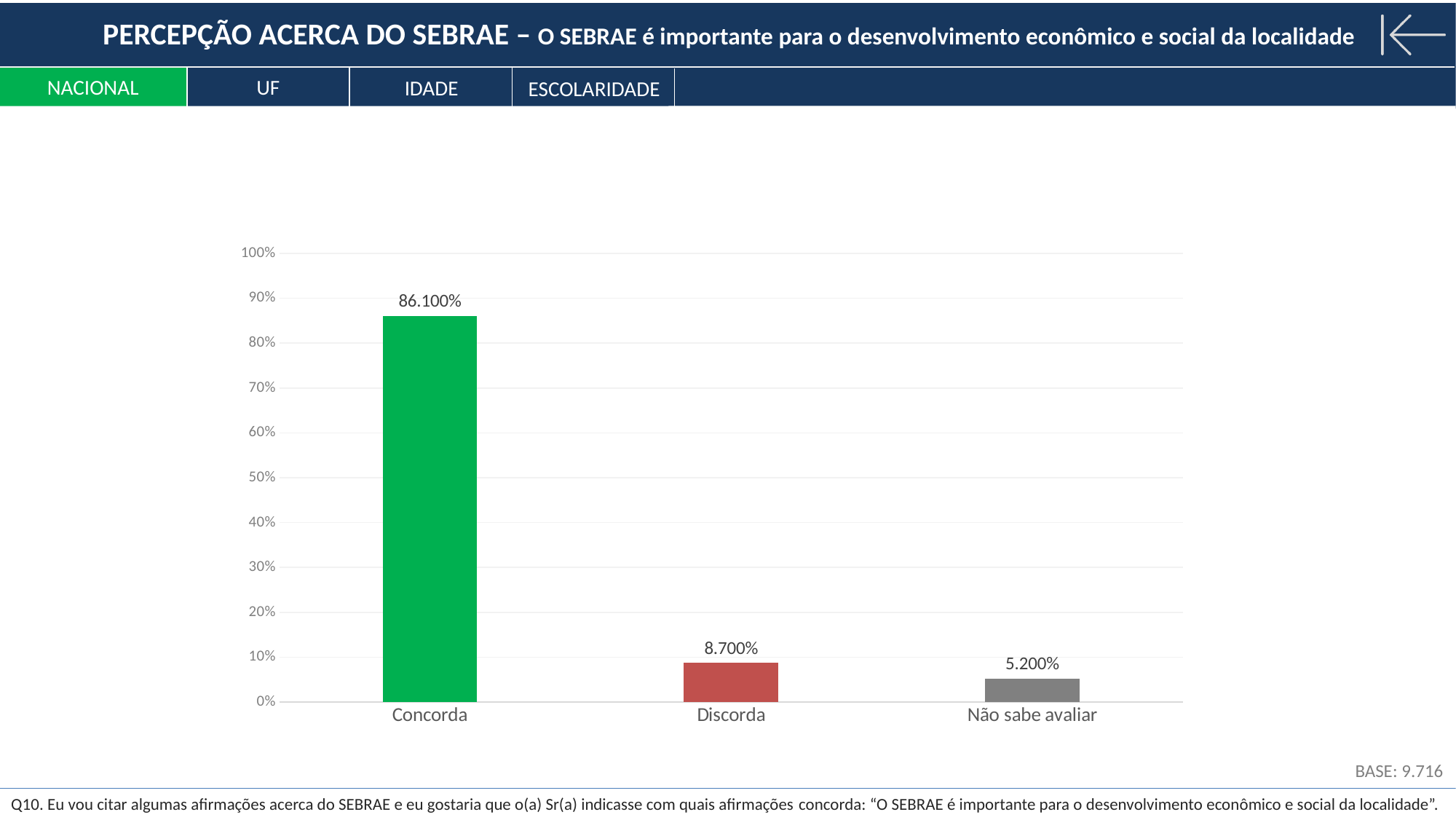
Which is larger, the value for Discorda or the value for Não sabe avaliar? Discorda What is the difference between the values for Concorda and Discorda? 77.400% Is the value for Concorda greater or less than 80%? greater Which category has the highest value? Concorda What colour is the bar for Concorda? green Which category has the lowest value? Não sabe avaliar What kind of chart is shown on the slide? bar chart What is the value for Concorda? 86.100% What is the value for Não sabe avaliar? 5.200% What is the value for Discorda? 8.700% How many categories are shown on the x axis? 3 What is the difference between the values for Discorda and Não sabe avaliar? 3.500%